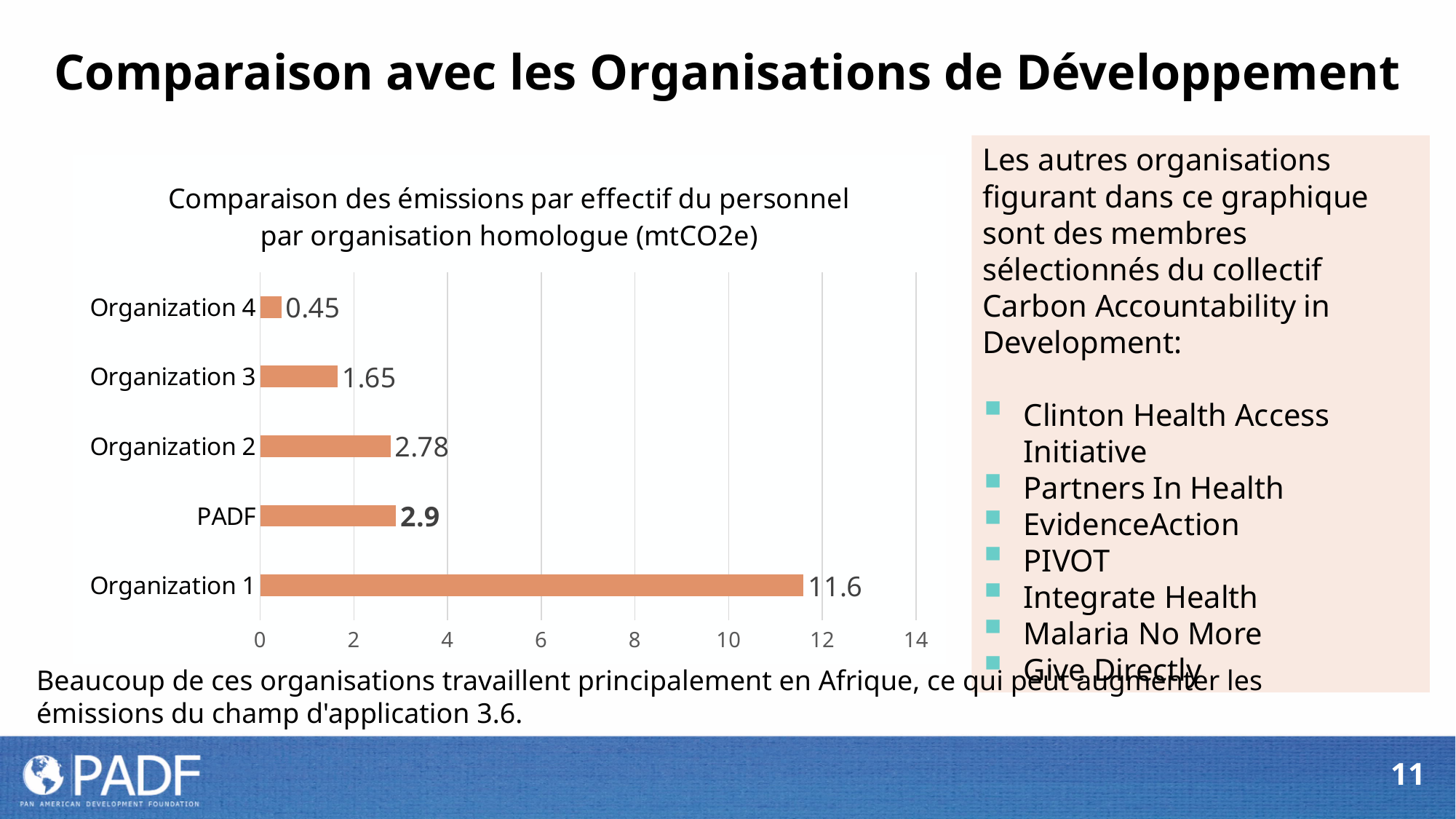
What is the value for Organization 1? 11.6 Which is larger, the value for Organization 2 or the value for Organization 3? Organization 2 What is the difference between the values for Organization 2 and Organization 3? 1.13 How many organizations are shown in the chart? 5 What is the value for Organization 3? 1.65 What is the difference between the values for Organization 1 and PADF? 8.7 Is the value for Organization 1 greater or less than 10? greater Which organization has the highest emissions per staff member? Organization 1 What is the value for Organization 4? 0.45 What is the value for PADF? 2.9 Which organization has the lowest emissions per staff member? Organization 4 What kind of chart is shown on the slide? Bar chart